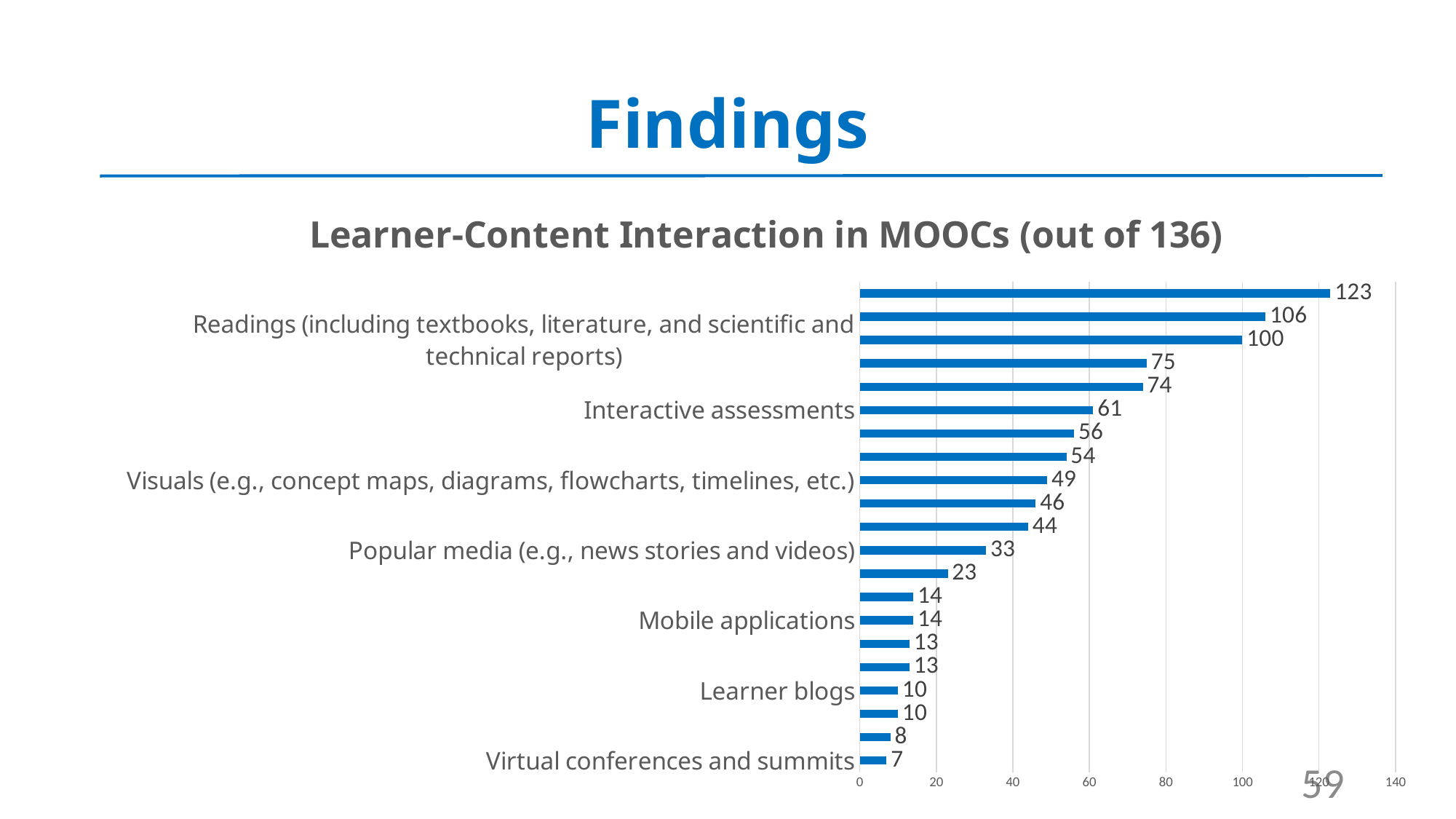
What is the value for Popular media (e.g., news stories and videos)? 33 How many bars are plotted on the chart? 21 What is the highest value shown on the chart? 123 What type of chart is shown on the slide? bar chart Which labeled category has the lowest value? Virtual conferences and summits What is the difference between the values for Interactive assessments and Popular media (e.g., news stories and videos)? 28 What is the value for Virtual conferences and summits? 7 What is the value for Interactive assessments? 61 What is the value for Mobile applications? 14 What is the value for Visuals (e.g., concept maps, diagrams, flowcharts, timelines, etc.)? 49 What is the value for Learner blogs? 10 What is the title of the chart? Learner-Content Interaction in MOOCs (out of 136)